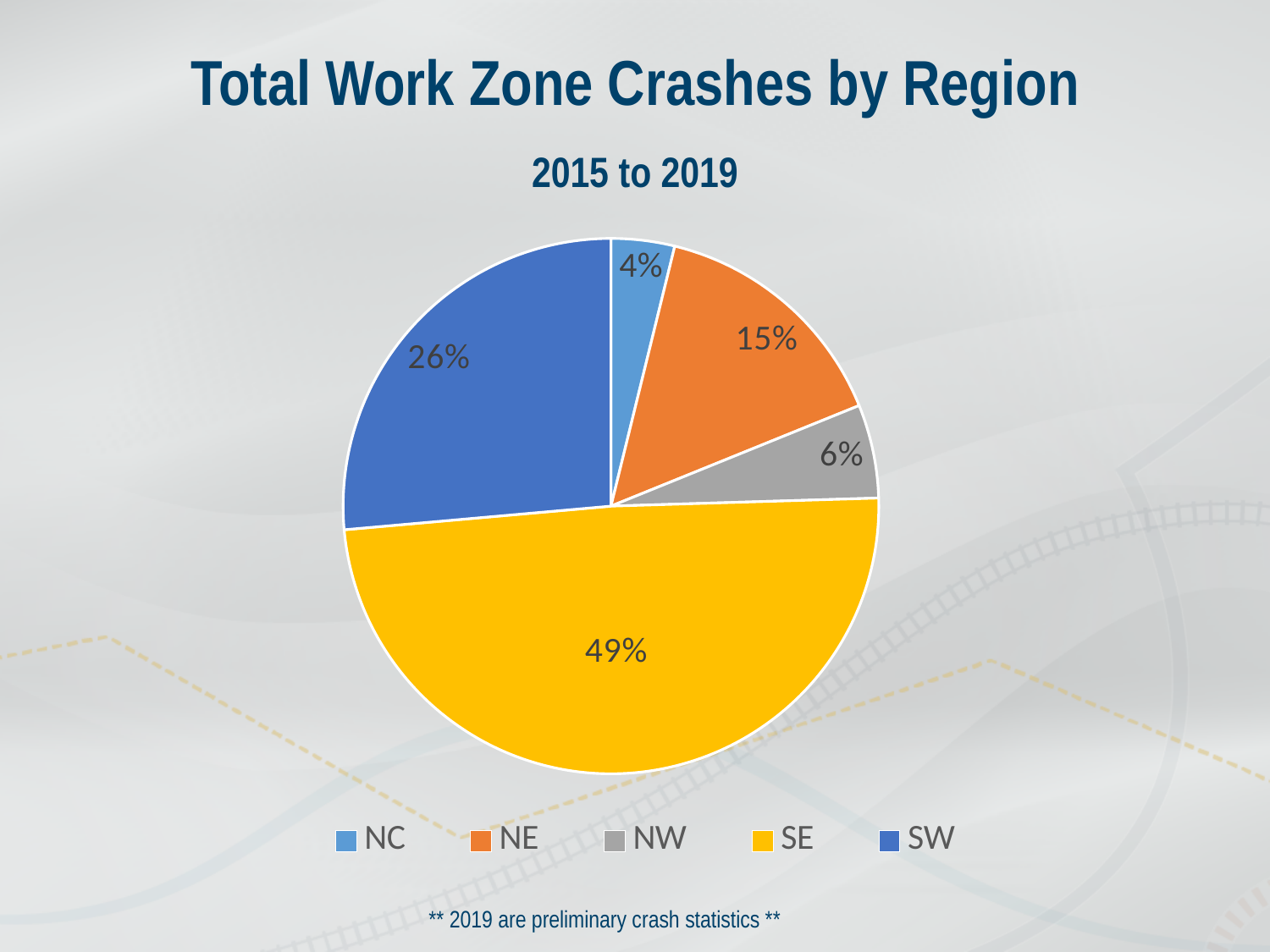
What share of total work zone crashes does the NE region account for? 15% What kind of chart is shown on the slide? Pie chart Which region has the smallest share of work zone crashes? NC What share of total work zone crashes does the SE region account for? 49% Which region has the largest share of work zone crashes? SE How many percentage points larger is the SE share than the SW share? 23 What time period does the chart cover, according to the subtitle? 2015 to 2019 How many regions are shown in the pie chart? 5 Which region has a larger share of work zone crashes, NE or NW? NE What share of total work zone crashes does the SW region account for? 26%